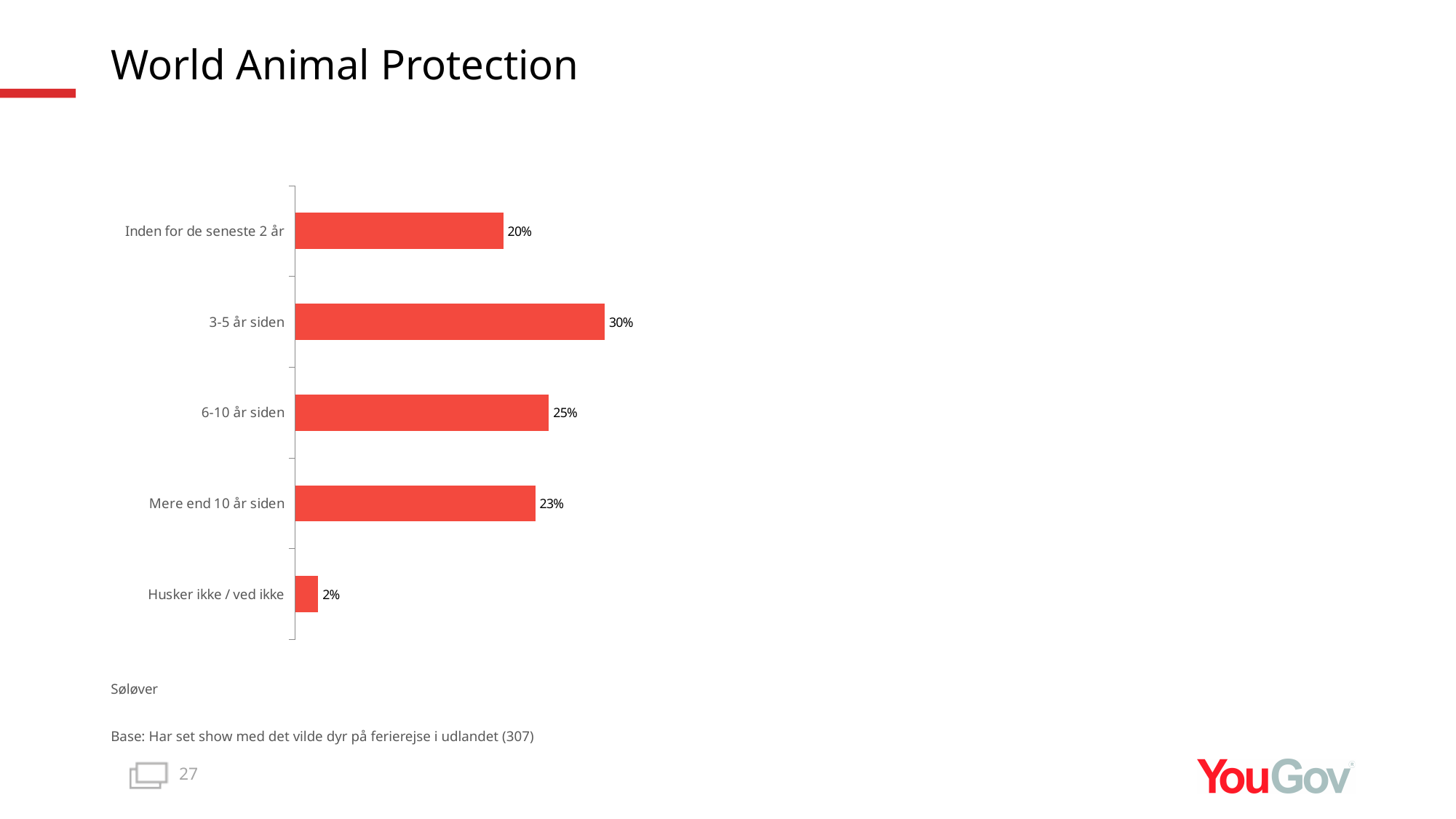
Which category has the lowest value? Husker ikke / ved ikke What is the value for "Husker ikke / ved ikke"? 2% What is the value for "Mere end 10 år siden"? 23% What is the label shown below the chart? Søløver What is the difference between the values for "3-5 år siden" and "6-10 år siden"? 5% Which is larger, the value for "6-10 år siden" or "Mere end 10 år siden"? 6-10 år siden Which category has the highest value? 3-5 år siden What kind of chart is shown on the slide? Bar chart What is the value for "3-5 år siden"? 30% What is the value for "Inden for de seneste 2 år"? 20% How many categories are shown in the chart? 5 What is the difference between the values for "Inden for de seneste 2 år" and "Husker ikke / ved ikke"? 18%